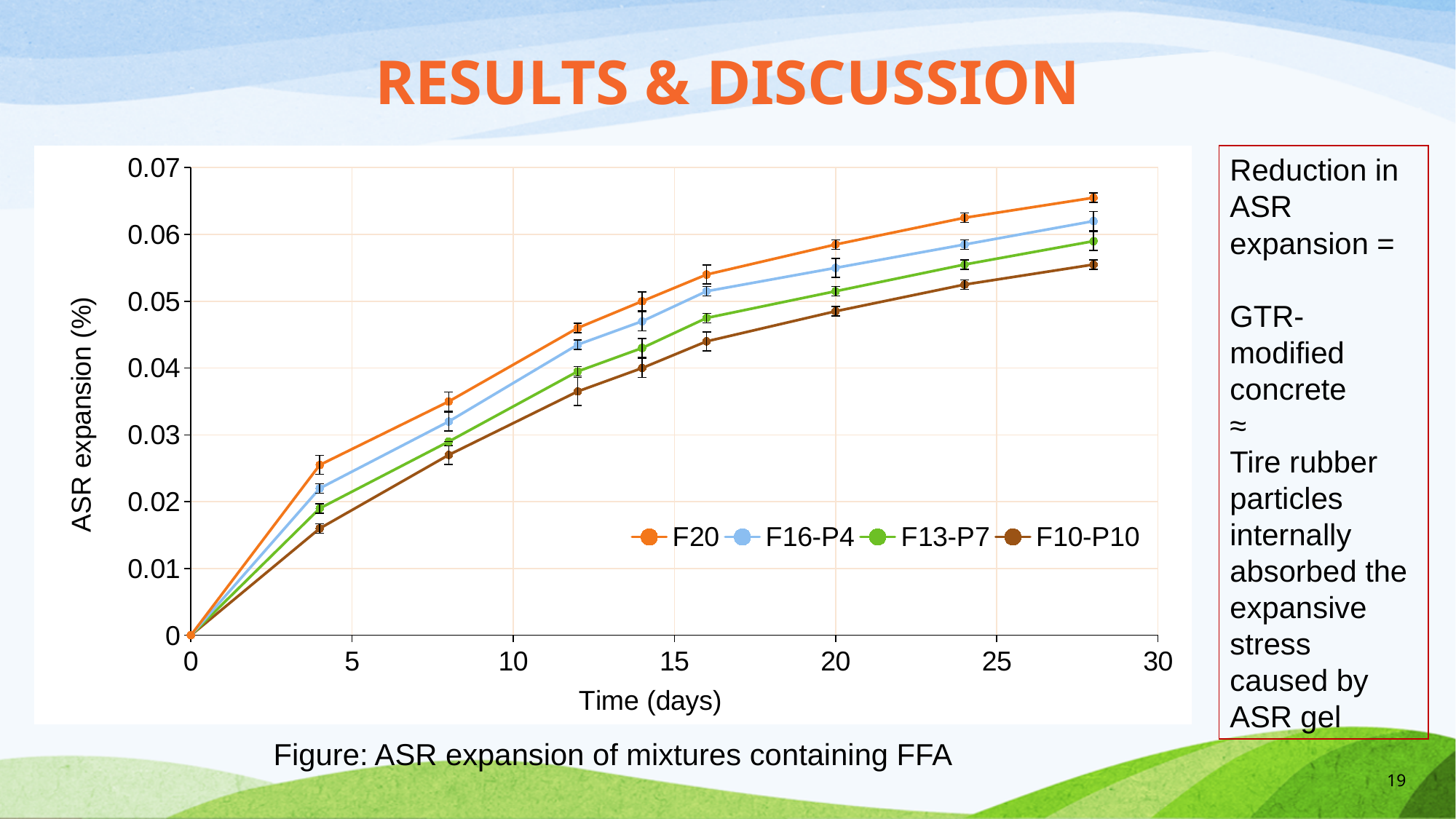
Which series has the lowest ASR expansion at 28 days? F10-P10 What kind of chart is shown on the slide? line chart Is the ASR expansion of F20 at 28 days greater or less than 0.06? greater How many series does the legend list? 4 Is the ASR expansion of F10-P10 at 28 days greater or less than 0.06? less What is the ASR expansion of all series at 0 days? 0 How many data points are plotted for the F20 series? 9 Do the ASR expansion values rise or fall as time increases? rise Which series has the highest ASR expansion at 28 days? F20 At 20 days, which is larger: the ASR expansion of F16-P4 or F13-P7? F16-P4 What is the label of the x axis? Time (days) Is the ASR expansion of F10-P10 at 4 days greater or less than 0.02? less